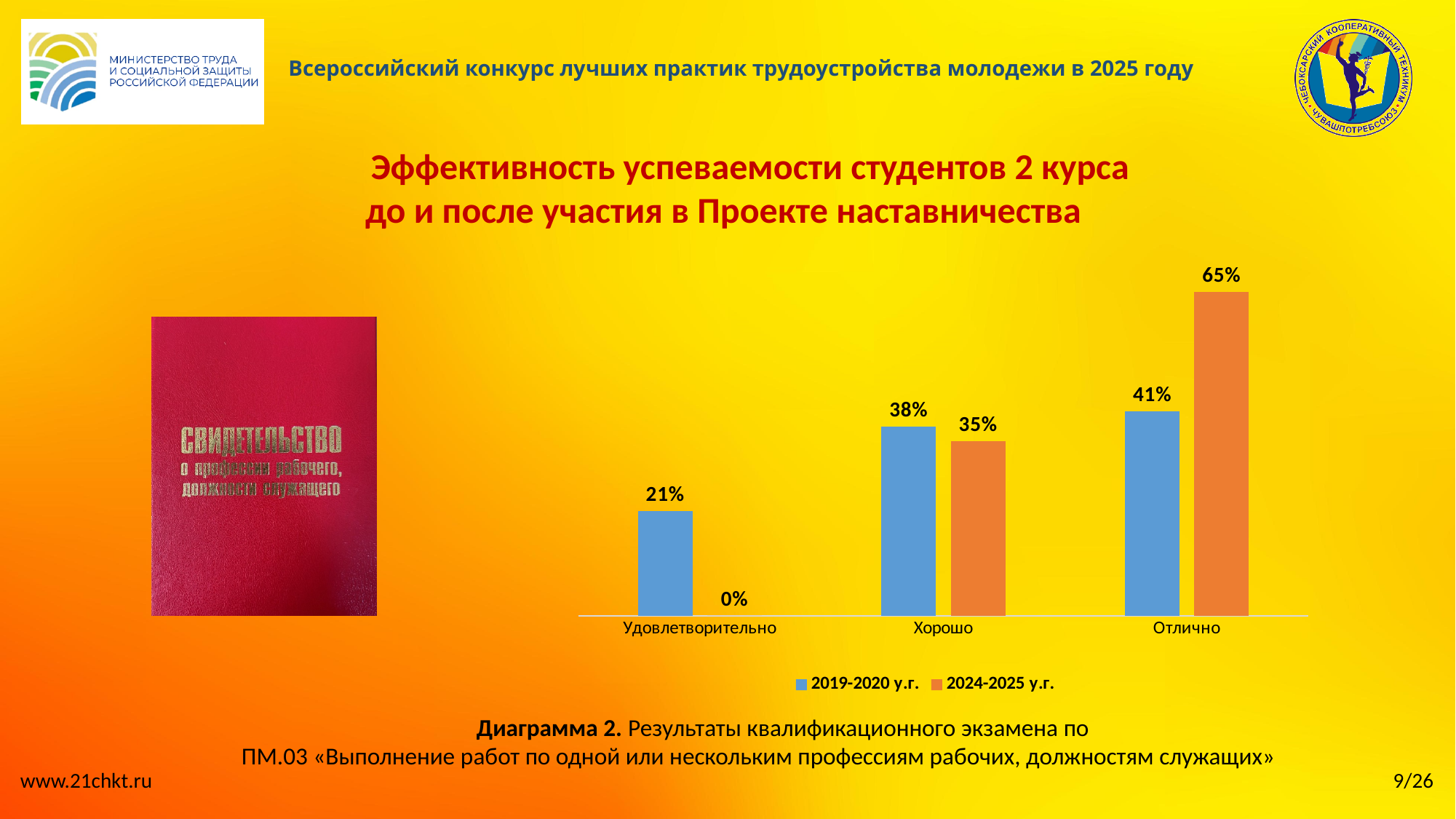
What kind of chart is shown on the slide? Bar chart What is the difference between the 2024-2025 у.г. and 2019-2020 у.г. values for Отлично? 24% What is the value for Хорошо in the 2024-2025 у.г. series? 35% What is the value for Удовлетворительно in the 2019-2020 у.г. series? 21% What is the value for Удовлетворительно in the 2024-2025 у.г. series? 0% Which category has the highest value in the 2019-2020 у.г. series? Отлично How many series does the chart legend list? 2 Which category has the lowest value in the 2024-2025 у.г. series? Удовлетворительно How many categories are shown on the x axis of the chart? 3 Which series has the larger value for Хорошо, 2019-2020 у.г. or 2024-2025 у.г.? 2019-2020 у.г. What is the value for Отлично in the 2024-2025 у.г. series? 65% Which colour represents the 2024-2025 у.г. series in the chart? Orange